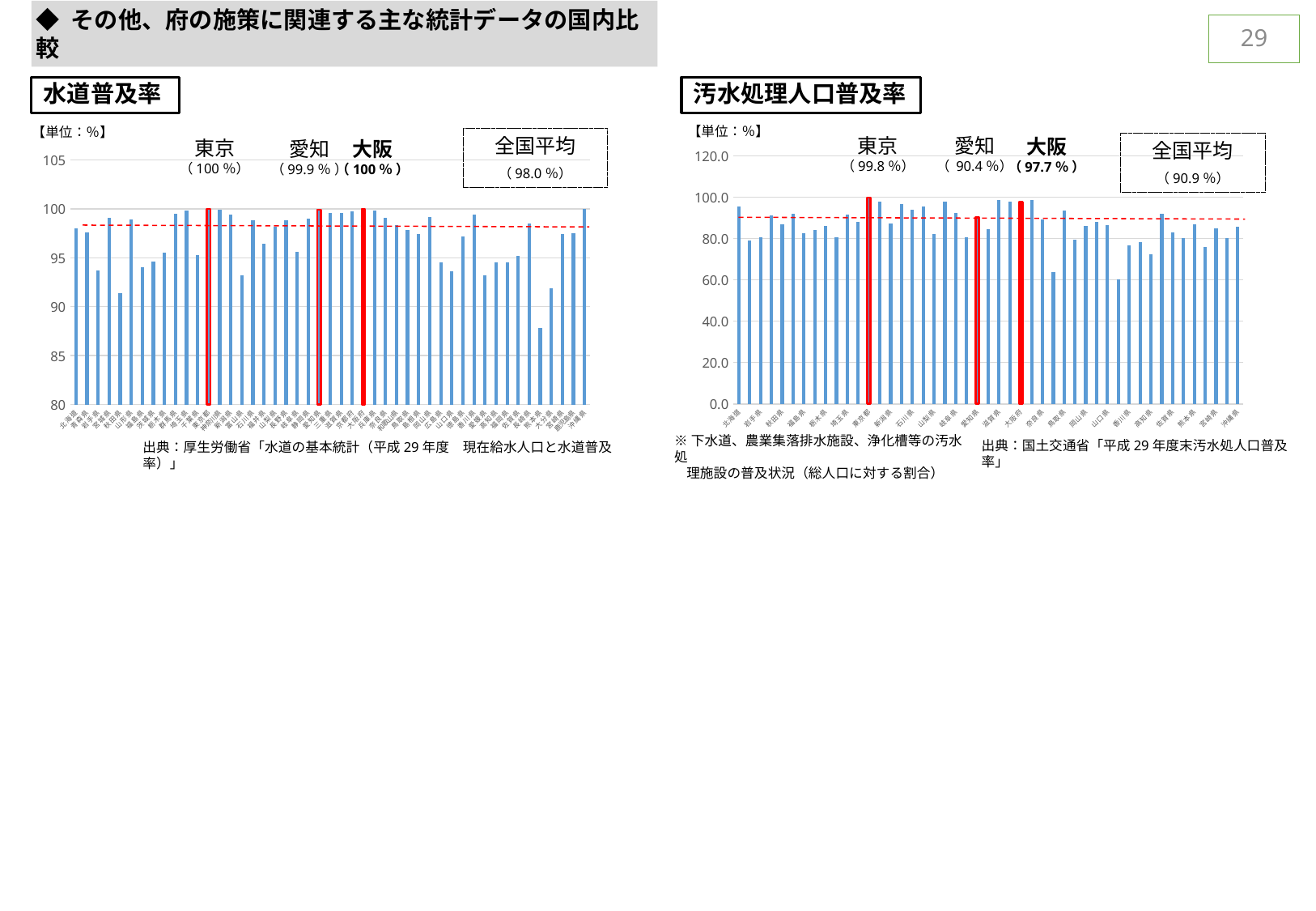
In the 汚水処理人口普及率 chart, what is the value for 東京? 99.8 % In the 汚水処理人口普及率 chart, how much higher is 大阪 than the 全国平均? 6.8 % In the 汚水処理人口普及率 chart, which is larger, 大阪 or 愛知? 大阪 In the 汚水処理人口普及率 chart, what colour are the highlighted bars for 東京, 愛知 and 大阪? red In the 水道普及率 chart, what is the value for 愛知? 99.9 % In the 水道普及率 chart, what is the 全国平均 value? 98.0 % In the 汚水処理人口普及率 chart, what is the value for 大阪? 97.7 % In the 水道普及率 chart, how much higher is 大阪 than the 全国平均? 2.0 % In the 汚水処理人口普及率 chart, how much higher is 東京 than 愛知? 9.4 % In the 汚水処理人口普及率 chart, what is the 全国平均 value? 90.9 % What kind of chart is the 水道普及率 chart? bar chart In the 水道普及率 chart, what is the value for 東京? 100 %